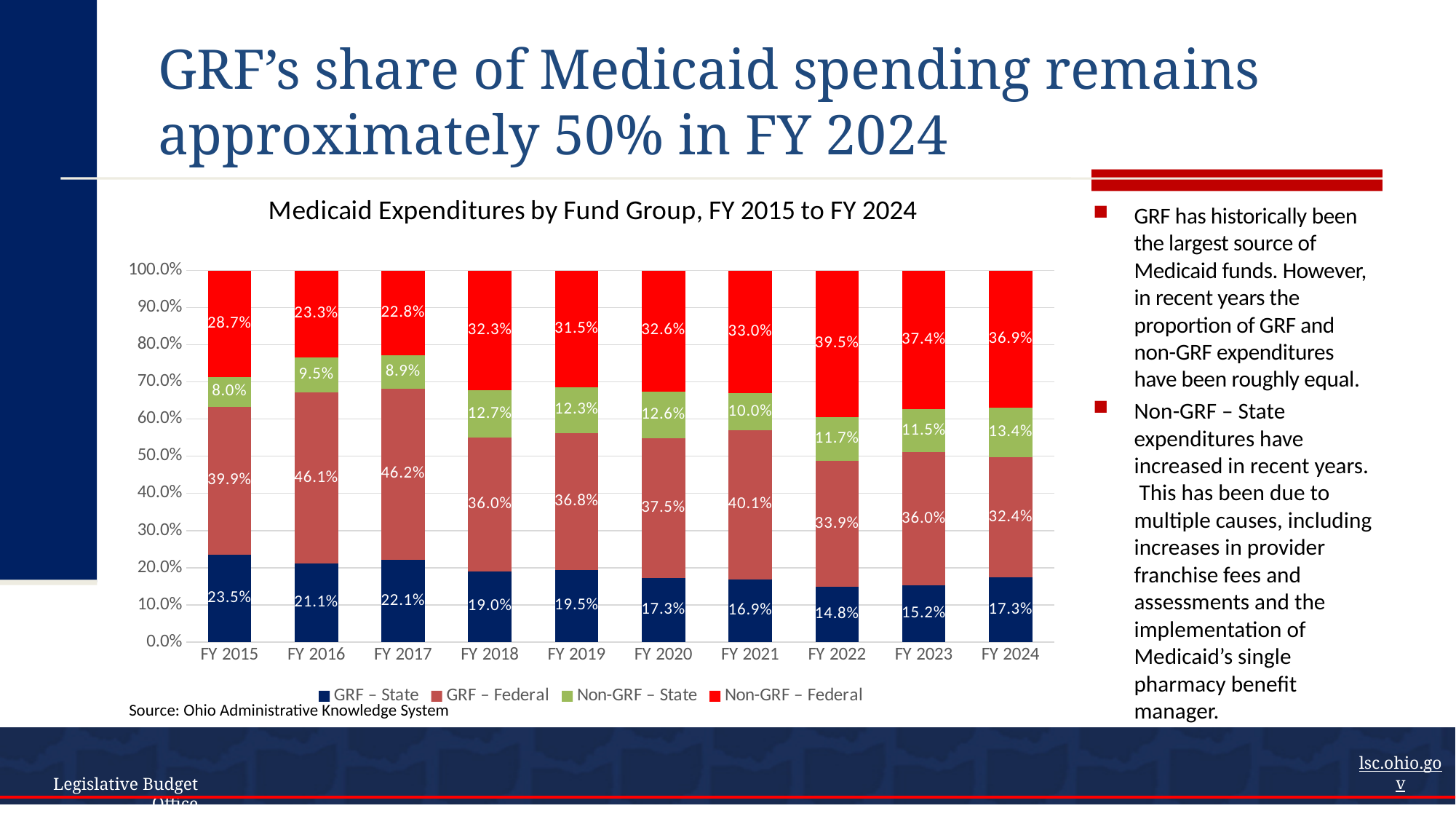
What is the GRF – Federal share in FY 2017? 46.2% What is the Non-GRF – Federal share in FY 2022? 39.5% In which fiscal year is the GRF – State share the lowest? FY 2022 What is the title of the chart? Medicaid Expenditures by Fund Group, FY 2015 to FY 2024 What is the combined GRF share (GRF – State plus GRF – Federal) in FY 2024? 49.7% What is the difference between the Non-GRF – State share in FY 2024 and in FY 2015? 5.4% How many fiscal years are shown on the x axis of the chart? 10 What kind of chart is shown on the slide? Stacked bar chart What is the GRF – State share of Medicaid expenditures in FY 2024? 17.3% Which is larger in FY 2021: the GRF – Federal share or the Non-GRF – Federal share? GRF – Federal In which fiscal year is the GRF – State share the highest? FY 2015 How many fund groups does the legend list? 4